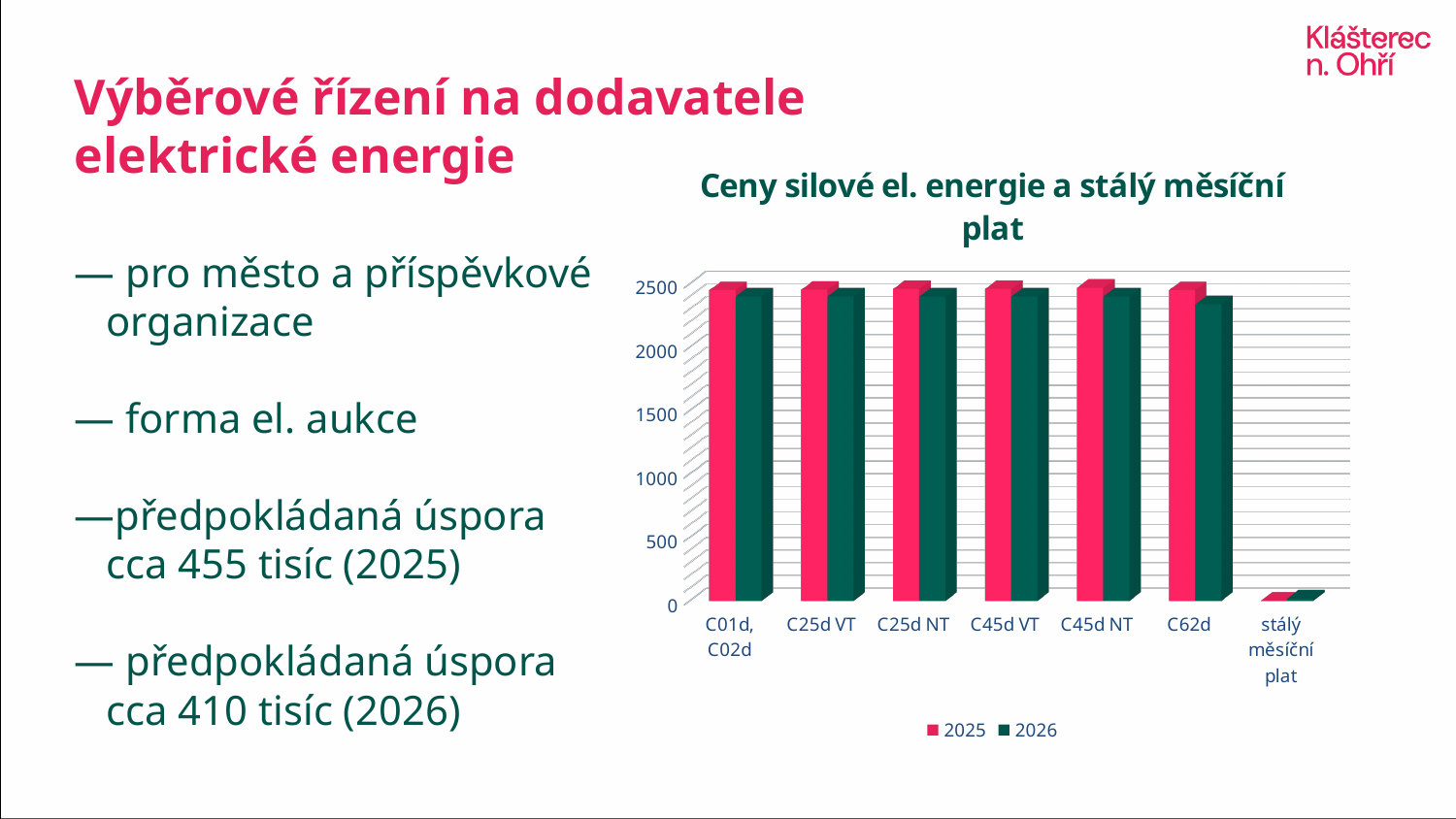
For C62d, which series has the larger value, 2025 or 2026? 2025 Which category has the lowest values in the chart? stálý měsíční plat Is the 2025 value for C25d VT greater or less than 2000? greater Is the 2026 value for C45d NT greater or less than 1500? greater What is the title of the chart? Ceny silové el. energie a stálý měsíční plat What kind of chart is shown on the slide? bar chart Is the 2026 value for C62d greater or less than 2000? greater Which is larger: the 2025 value for C01d, C02d or the 2025 value for stálý měsíční plat? C01d, C02d How many categories are shown on the x axis of the chart? 7 How many series does the chart's legend list? 2 Which series are listed in the chart's legend? 2025 and 2026